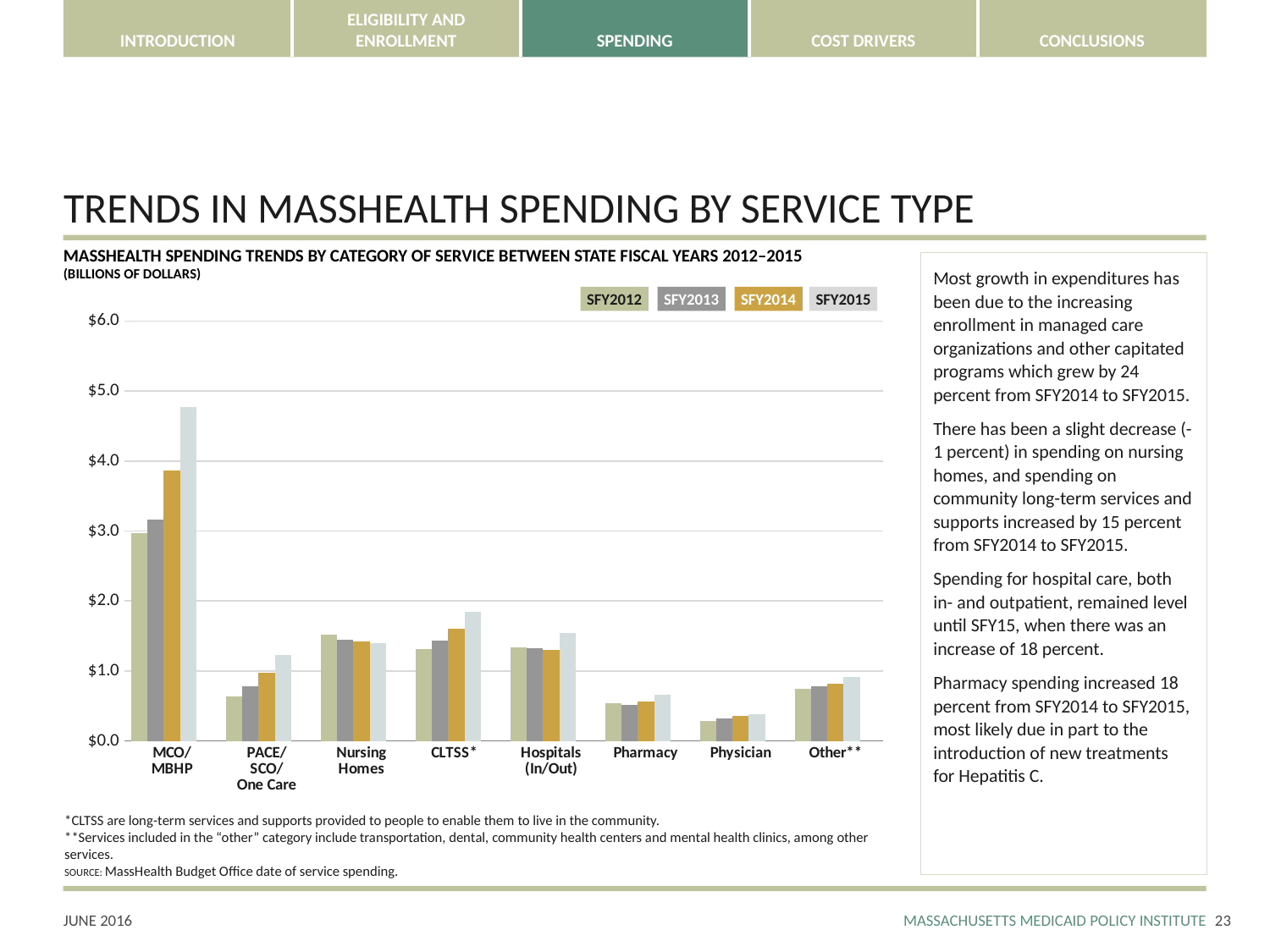
Do the Nursing Homes values rise or fall from SFY2012 to SFY2015? fall What kind of chart is shown on the slide? bar chart Which service category has the highest SFY2015 spending? MCO/MBHP Is the SFY2015 value for Physician greater or less than $1.0? less What unit are the chart's values expressed in, according to the subtitle? Billions of dollars How many service categories are shown on the x axis? 8 Which service category has the lowest SFY2012 spending? Physician Which is larger in SFY2015: spending on CLTSS or spending on Hospitals (In/Out)? CLTSS Is the SFY2015 value for PACE/SCO/One Care greater or less than $1.0? greater Do the MCO/MBHP values rise or fall from SFY2012 to SFY2015? rise Is the SFY2015 value for MCO/MBHP greater or less than $4.0? greater How many series does the legend list? 4